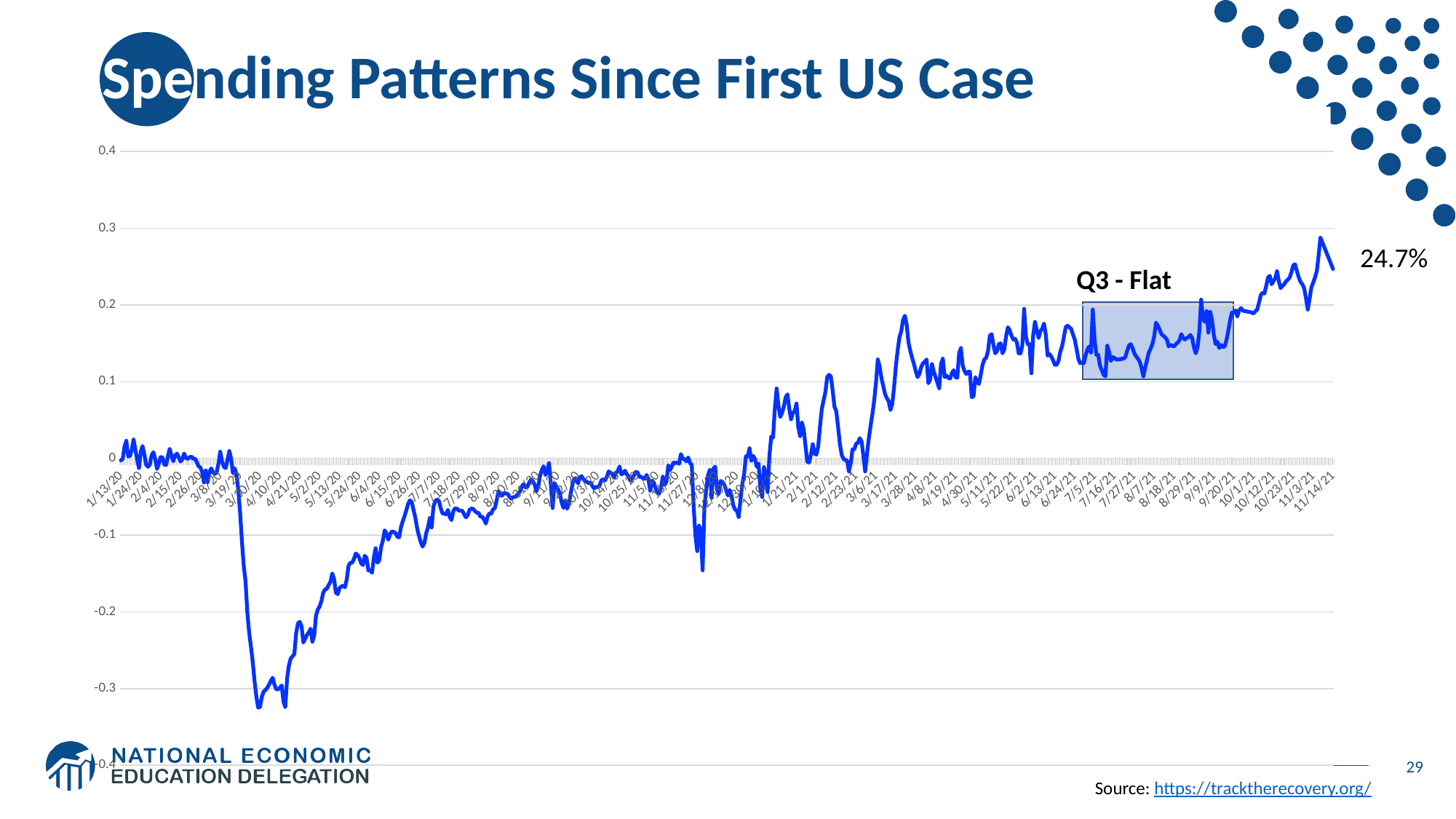
Is the value at 1/13/20 greater or less than 0.1? less Is the value at 3/28/21 greater or less than 0? greater Do the values generally rise or fall between 3/30/20 and 11/14/21? rise What is the highest value shown on the y axis? 0.4 How many lines are plotted on the chart? 1 What value is labelled at the right end of the line? 24.7% What kind of chart is shown on the slide? line chart Is the lowest value on the chart greater or less than -0.3? less What label is written above the shaded box on the chart? Q3 - Flat What is the title of the chart? Spending Patterns Since First US Case